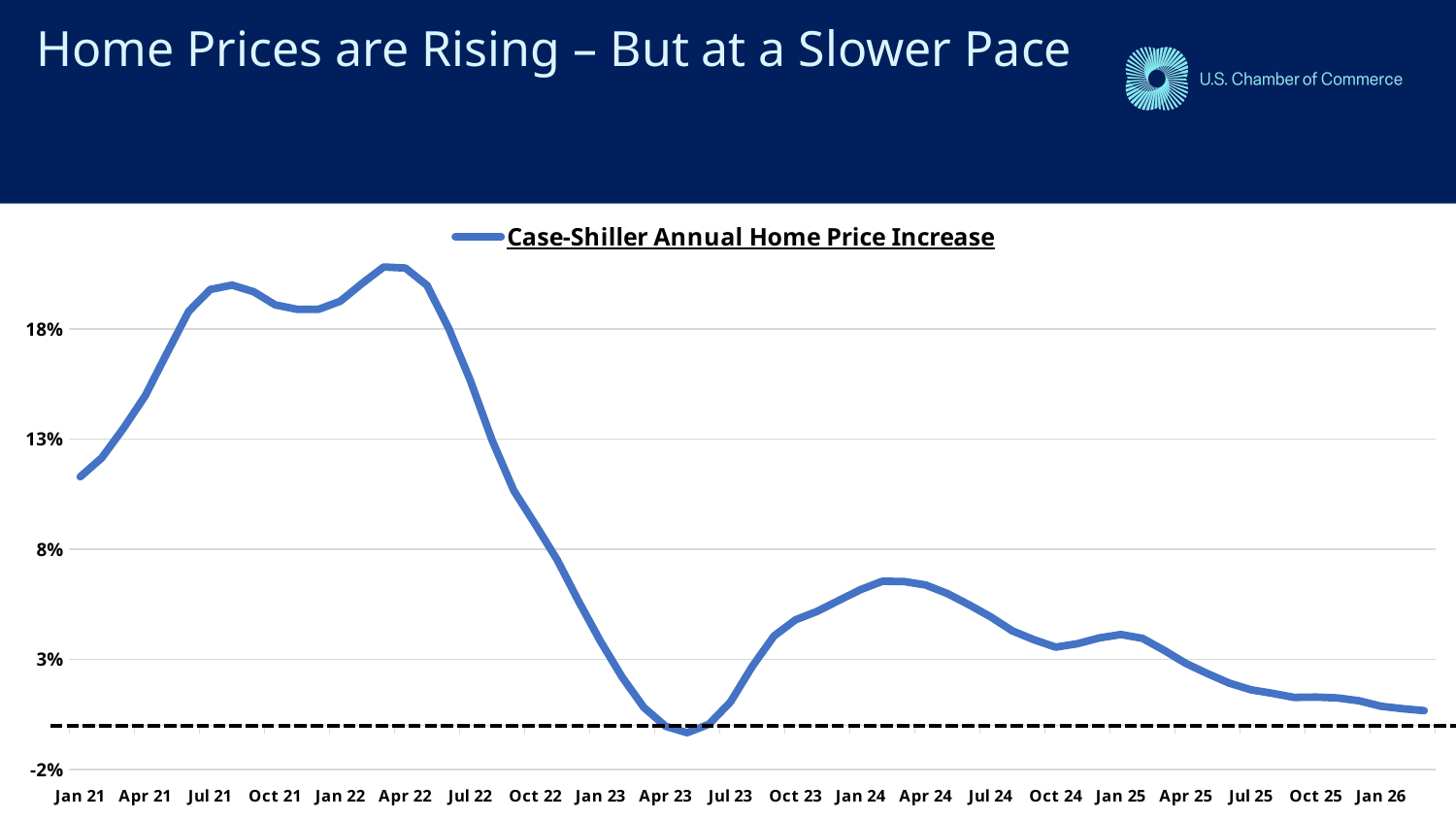
Which is larger, the value for Jan 21 or the value for Jan 24? Jan 21 How many date labels are shown along the x axis? 21 Does the line rise or fall between Apr 22 and Apr 23? fall Which x-axis label has the highest value on the line? Apr 22 How many series does the legend list? 1 What kind of chart is shown on the slide? line chart What is the name of the series shown in the legend? Case-Shiller Annual Home Price Increase Is the value for Apr 23 greater or less than 3%? less Is the value for Jan 26 greater or less than 3%? less Is the value for Apr 22 greater or less than 18%? greater